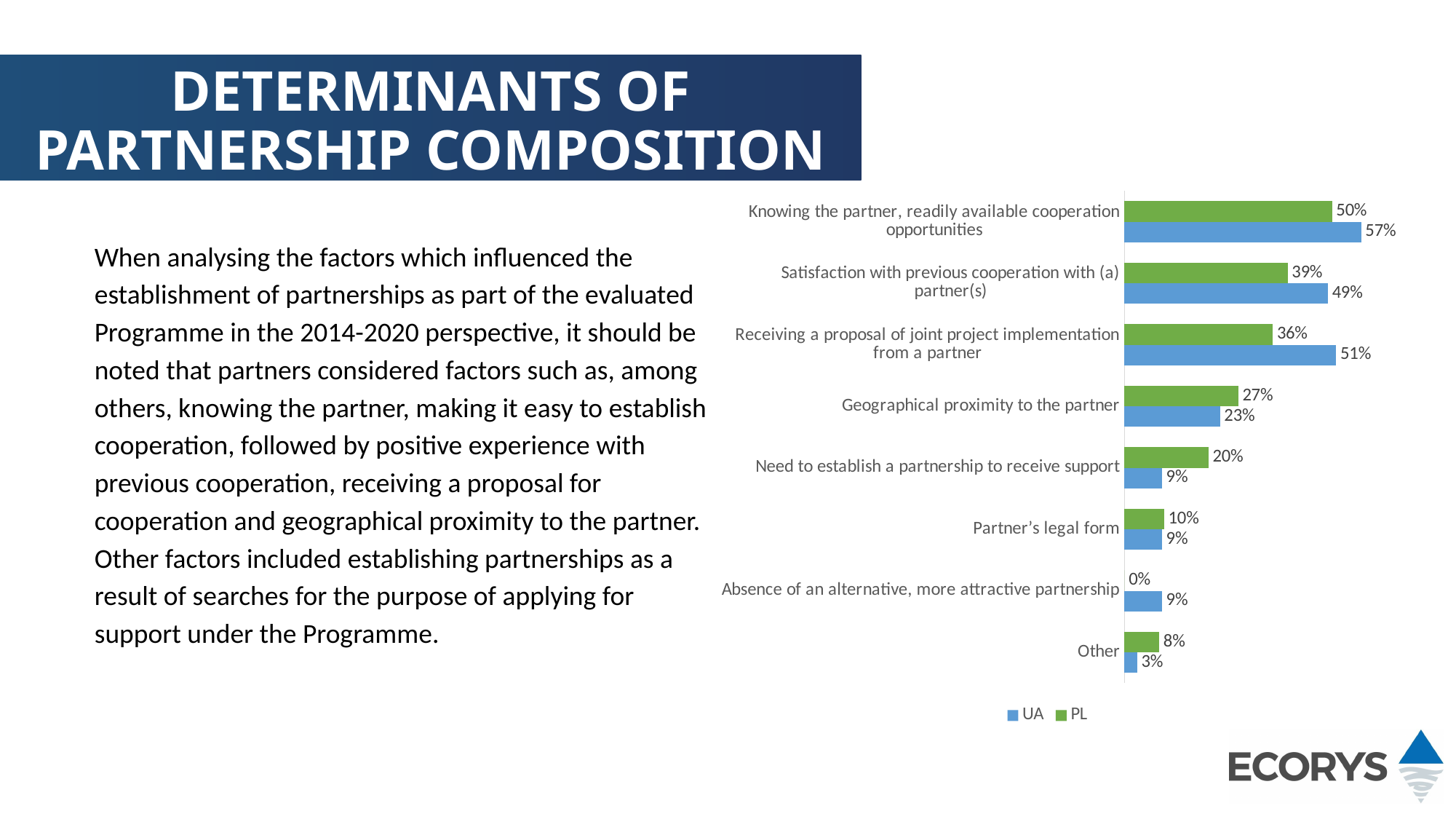
What is the difference between the UA and PL values for "Geographical proximity to the partner"? 4% How many series does the legend list? 2 How many categories are shown in the chart? 8 What is the UA value for "Knowing the partner, readily available cooperation opportunities"? 57% What kind of chart is shown on the slide? Bar chart For "Need to establish a partnership to receive support", which is larger, the UA value or the PL value? PL What is the PL value for "Absence of an alternative, more attractive partnership"? 0% Which category has the lowest UA value? Other Which category has the highest UA value? Knowing the partner, readily available cooperation opportunities Which colour represents the PL series in the chart? Green What is the PL value for "Satisfaction with previous cooperation with (a) partner(s)"? 39% What is the UA value for "Receiving a proposal of joint project implementation from a partner"? 51%